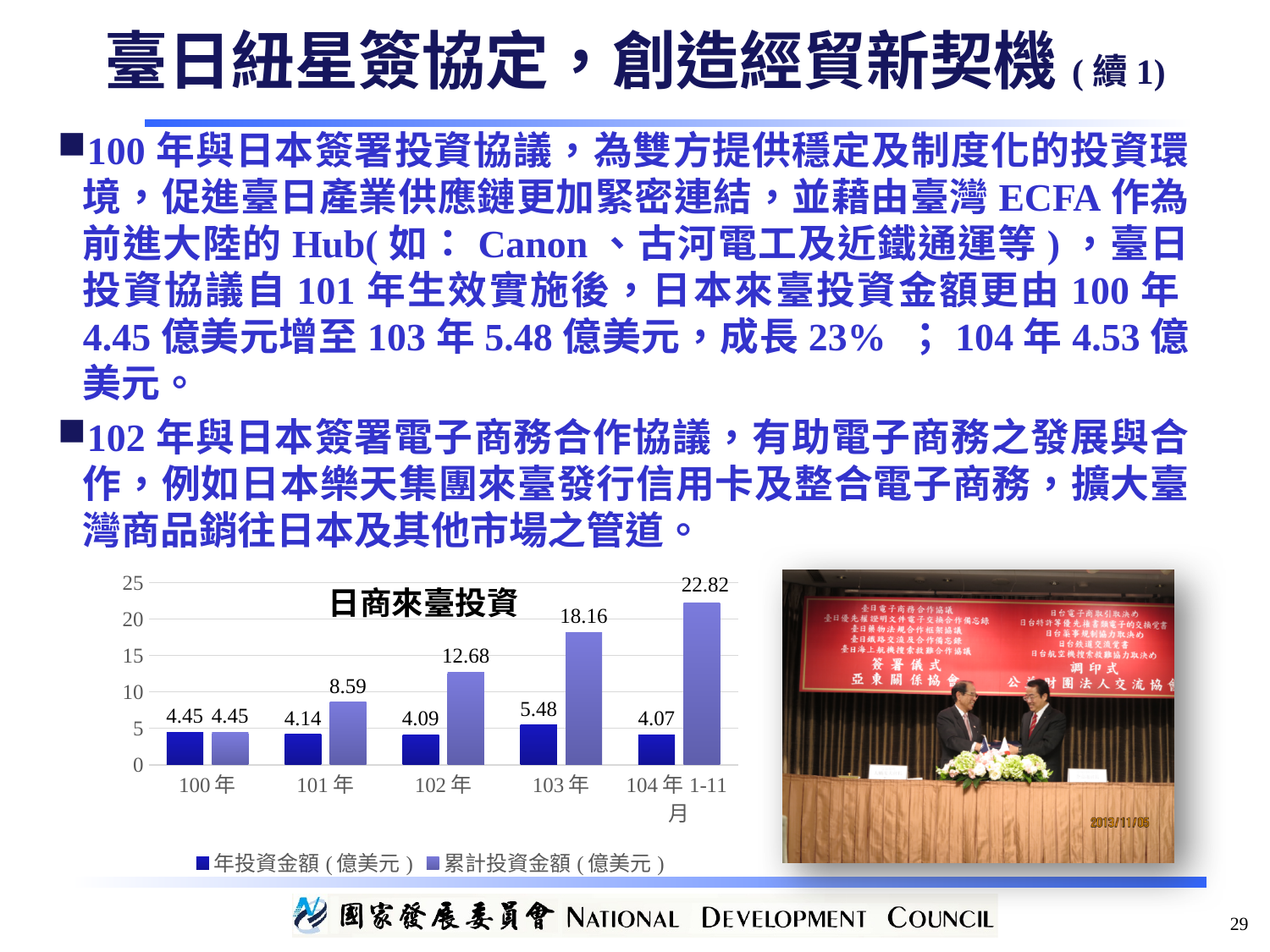
In the 日商來臺投資 chart, what is the 累計投資金額 (億美元) for 102年? 12.68 In the 日商來臺投資 chart, is the 累計投資金額 for 104年1-11月 greater or less than 20? greater In the 日商來臺投資 chart, what is the 年投資金額 (億美元) for 103年? 5.48 In the 日商來臺投資 chart, does the 累計投資金額 series rise or fall from 100年 to 104年1-11月? rise In the 日商來臺投資 chart, which year has the highest 年投資金額 (億美元)? 103年 How many categories are shown on the x axis of the 日商來臺投資 chart? 5 In the 日商來臺投資 chart, which category has the lowest 年投資金額 (億美元)? 104年1-11月 How many series does the legend of the 日商來臺投資 chart list? 2 In the 日商來臺投資 chart, which is larger: the 年投資金額 for 101年 or for 102年? 101年 What type of chart is shown under the title 日商來臺投資? bar chart In the 日商來臺投資 chart, what is the difference between the 累計投資金額 for 103年 and for 102年? 5.48 In the 日商來臺投資 chart, what is the 累計投資金額 (億美元) for 104年1-11月? 22.82